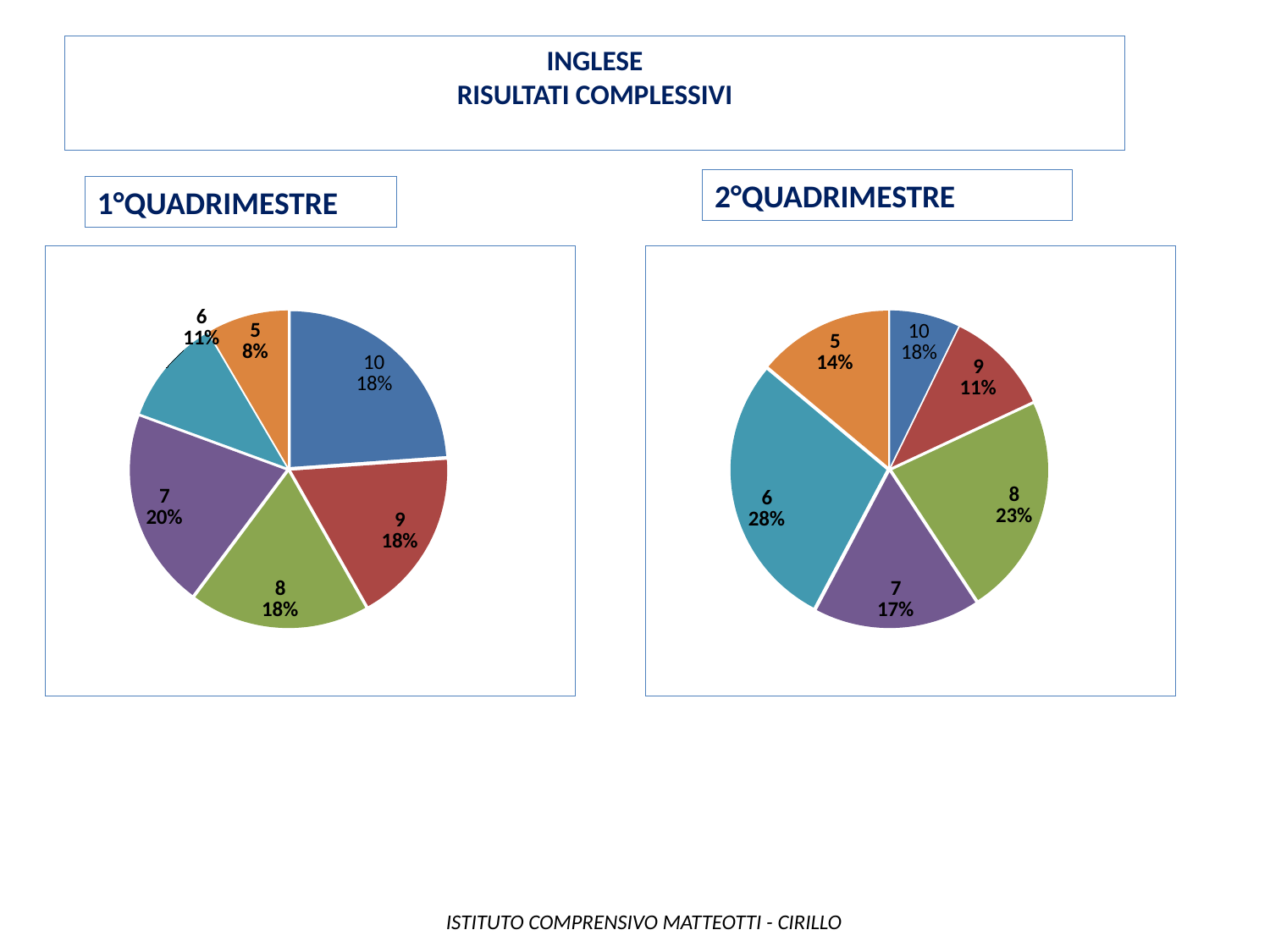
In the 2°QUADRIMESTRE chart, what is the difference in percentage points between the shares of grade 6 and grade 5? 14 In the 2°QUADRIMESTRE chart, which grade has the largest slice? 6 In the 2°QUADRIMESTRE chart, which is larger, the share of grade 8 or the share of grade 7? 8 In the 2°QUADRIMESTRE chart, what share does grade 8 have? 23% What type of chart is the 1°QUADRIMESTRE chart? Pie chart In the 1°QUADRIMESTRE chart, what share does grade 7 have? 20% In the 1°QUADRIMESTRE chart, what share does grade 5 have? 8% In the 1°QUADRIMESTRE chart, how many slices does the pie have? 6 In the 1°QUADRIMESTRE chart, which grade has the smallest slice? 5 In the 2°QUADRIMESTRE chart, which grade has the smallest slice? 10 In the 1°QUADRIMESTRE chart, which grade has the largest slice? 10